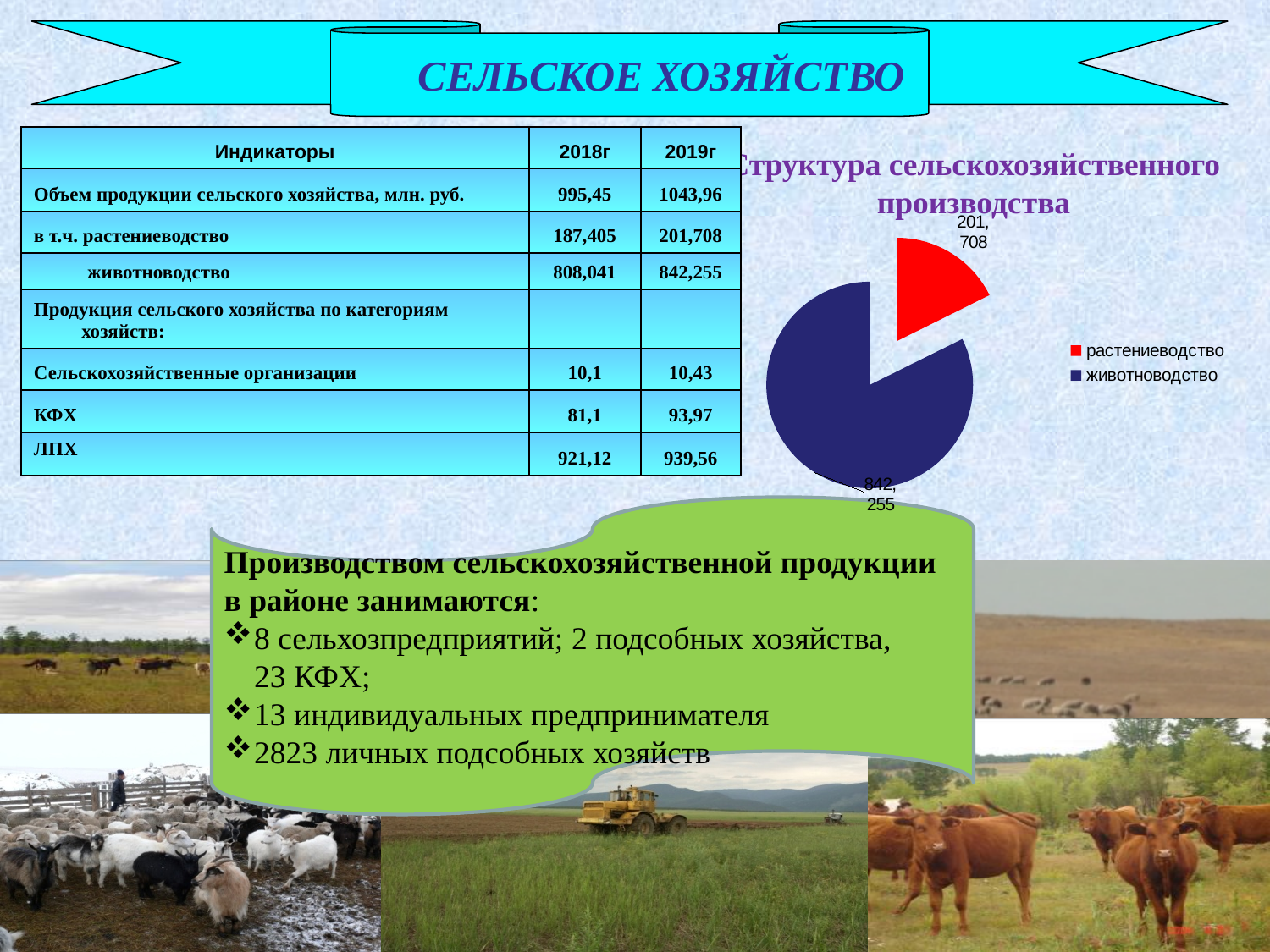
How many series does the legend of the pie chart list? 2 Which colour represents животноводство in the pie chart? dark blue What is the title of the pie chart? Структура сельскохозяйственного производства What is the value shown for животноводство in the pie chart? 842,255 What kind of chart is shown on the slide? pie chart What is the value shown for растениеводство in the pie chart? 201,708 What is the total of the two values shown in the pie chart? 1043,963 How many slices does the pie chart have? 2 Which slice of the pie chart is the largest? животноводство What is the difference between the животноводство and растениеводство values in the pie chart? 640,547 In the pie chart, which is larger: растениеводство or животноводство? животноводство Which slice of the pie chart is the smallest? растениеводство